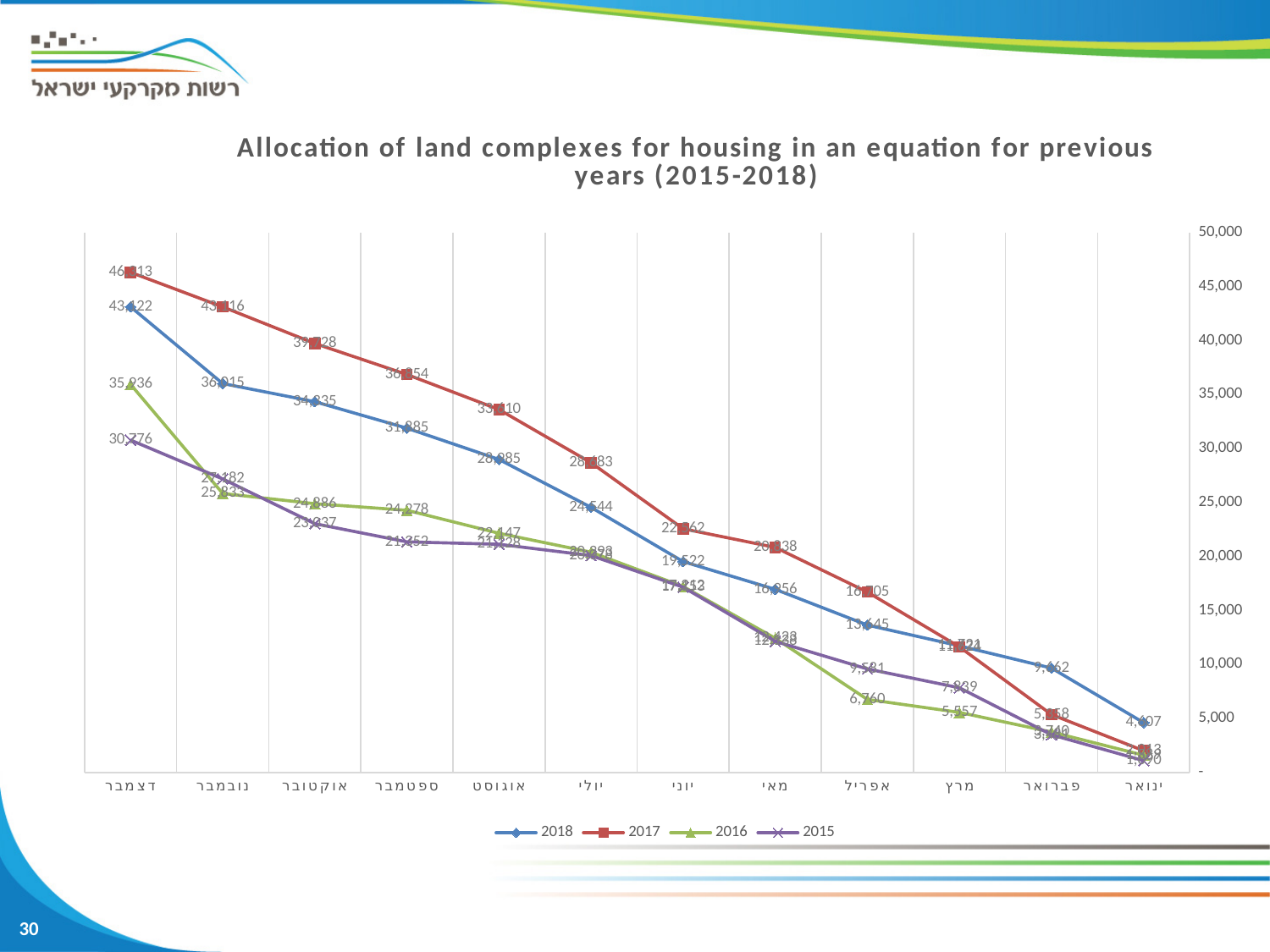
Which series has the lowest value at the rightmost month (ינואר)? 2015 Moving from left to right along the x axis, do the values of the series rise or fall? fall Is the value for 2017 at דצמבר greater or less than 45,000? greater How many series does the legend list? 4 What is the value for 2016 at אפריל? 6,760 What kind of chart is shown on the slide? line chart Which series is higher at the leftmost month (דצמבר): 2017 or 2018? 2017 Which series is lower at אפריל: 2016 or 2015? 2016 How many months are shown along the x axis? 12 What is the value for 2016 at מרץ? 5,557 Which series reaches the highest value on the chart? 2017 Is the value for 2018 at ינואר greater or less than 5,000? less